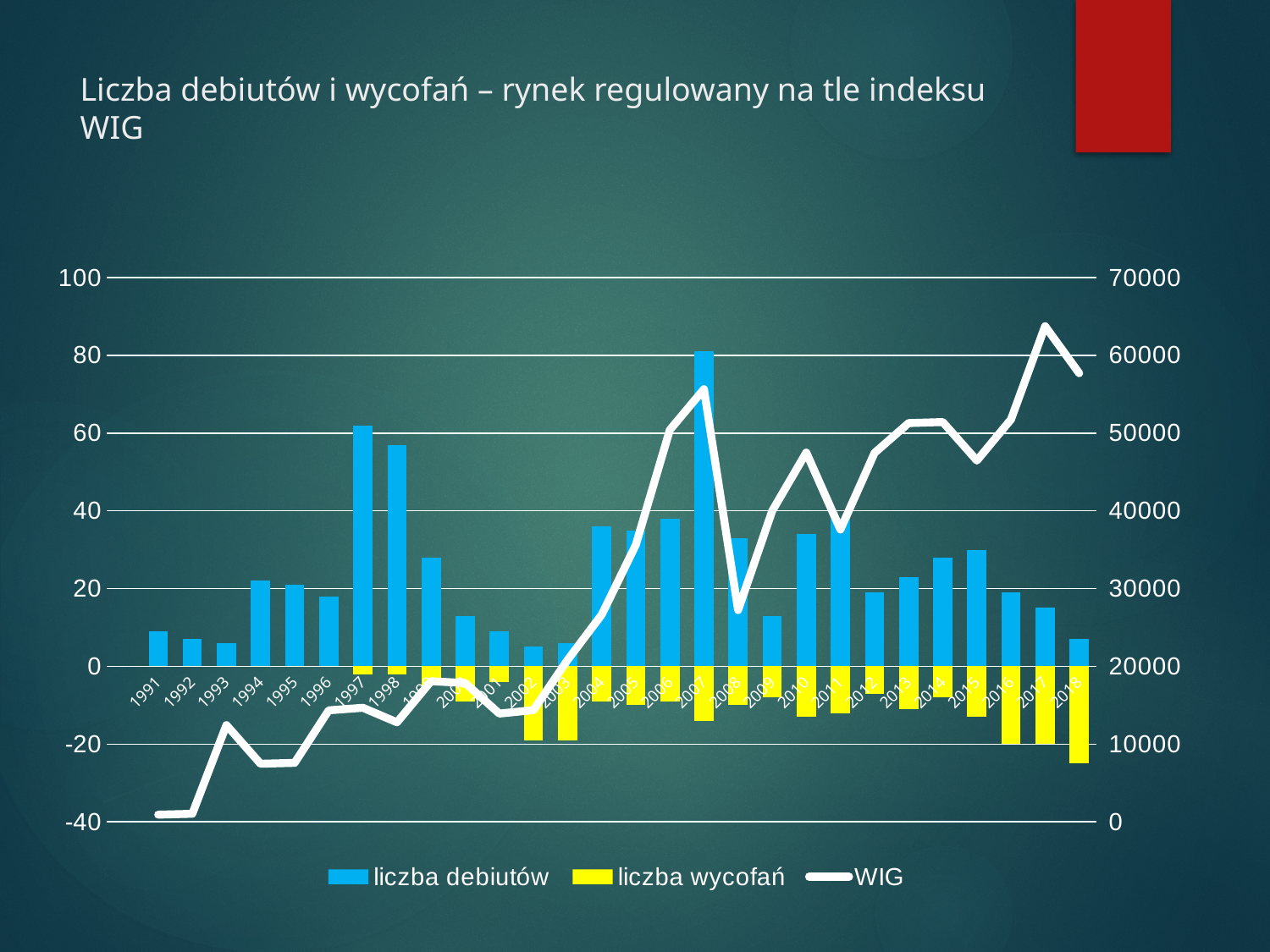
Is the WIG value in 2007 greater or less than 50000? greater How many years are shown on the x axis? 28 Does the WIG line rise or fall from 2003 to 2007? rises In which year does the WIG line reach its highest point? 2017 How many series does the legend list? 3 In which year is the liczba wycofań bar the longest (most negative)? 2018 Which year has a larger value for liczba debiutów, 2007 or 2010? 2007 Is the WIG value in 1991 greater or less than 10000? less Is the value for liczba debiutów in 2004 greater or less than 20? greater What kind of chart is shown on the slide? A combination bar and line chart Which year has a larger value for liczba debiutów, 1997 or 1998? 1997 In which year is the value for liczba debiutów highest? 2007